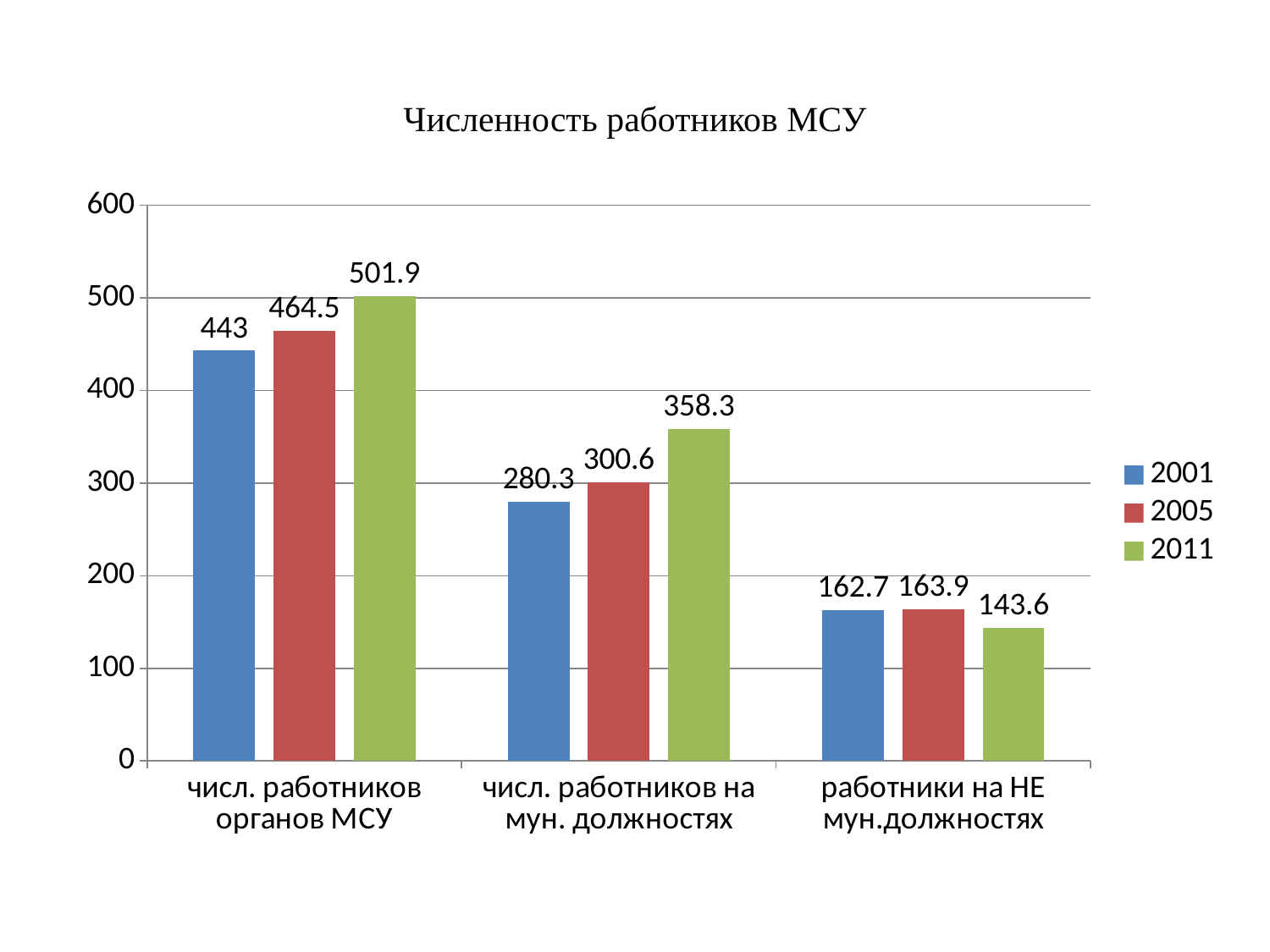
What kind of chart is shown on the slide? Bar chart How many categories are shown on the x axis? 3 What is the value for 2001 in the category "числ. работников на мун. должностях"? 280.3 How many series does the legend list? 3 What is the difference between the 2011 and 2001 values in the category "числ. работников органов МСУ"? 58.9 What is the difference between the 2011 and 2005 values in the category "числ. работников на мун. должностях"? 57.7 Which year has the lowest value in the category "работники на НЕ мун.должностях"? 2011 What is the value for 2011 in the category "числ. работников органов МСУ"? 501.9 Which year has the highest value in the category "числ. работников органов МСУ"? 2011 What is the value for 2005 in the category "работники на НЕ мун.должностях"? 163.9 What is the title of the chart? Численность работников МСУ Which is larger: the 2005 value for "числ. работников на мун. должностях" or the 2001 value for "работники на НЕ мун.должностях"? 2005 value for "числ. работников на мун. должностях"